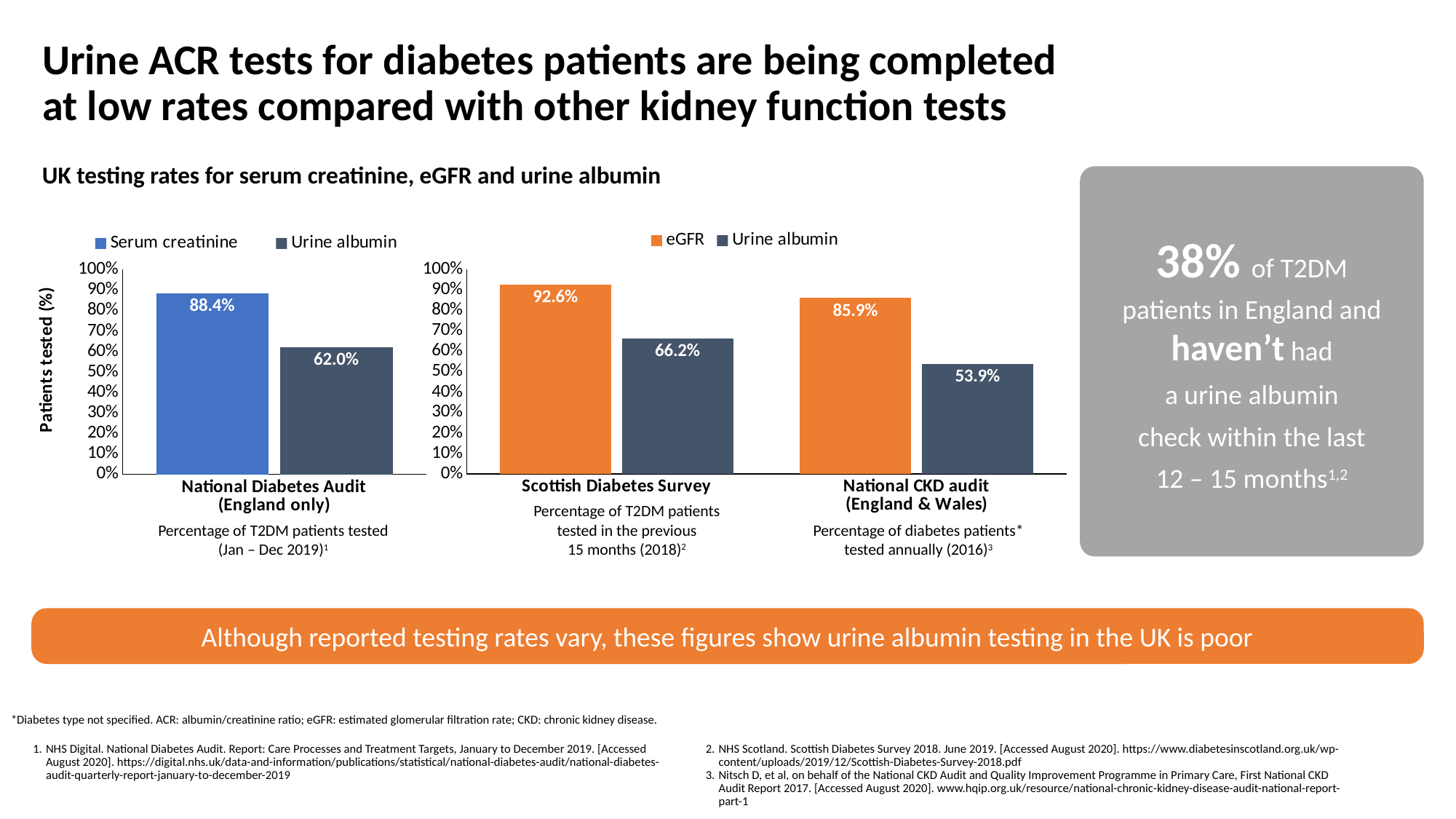
How many series does the legend of the right chart list? 2 In the right chart, what is the Urine albumin value for the National CKD audit (England & Wales)? 53.9% In the right chart, what is the difference between the eGFR and Urine albumin values for the National CKD audit? 32.0% In the left chart (National Diabetes Audit), what is the difference between the Serum creatinine and Urine albumin values? 26.4% What is the label on the y axis of the left chart? Patients tested (%) In the right chart, what is the eGFR value for the Scottish Diabetes Survey? 92.6% In the right chart, what is the Urine albumin value for the Scottish Diabetes Survey? 66.2% In the right chart, which is larger: the eGFR value for the Scottish Diabetes Survey or the eGFR value for the National CKD audit? Scottish Diabetes Survey In the right chart, which category has the lowest Urine albumin value? National CKD audit (England & Wales) What kind of chart is the left chart (National Diabetes Audit)? Bar chart In the left chart (National Diabetes Audit), what is the value for Serum creatinine? 88.4% In the left chart (National Diabetes Audit), what is the value for Urine albumin? 62.0%